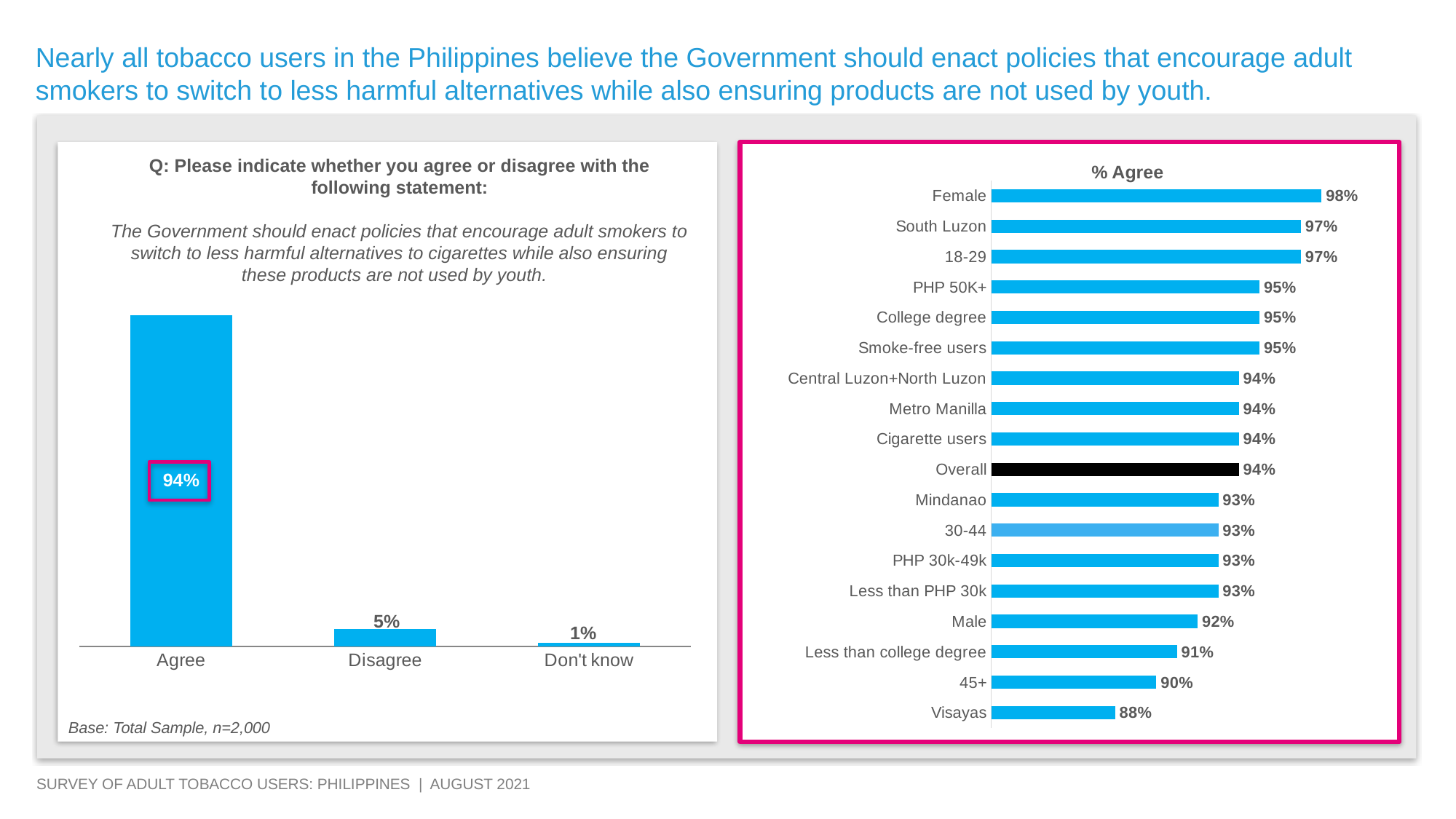
In the % Agree chart, what is the value for Overall? 94% In the left chart, what percentage of respondents answered Don't know? 1% In the % Agree chart, what is the value for Visayas? 88% In the left chart, what is the difference between the Agree and Disagree percentages? 89 percentage points In the % Agree chart, what is the difference between Female and Male? 6 percentage points In the left chart, how many response categories are shown on the x axis? 3 In the % Agree chart, which is larger, the value for 18-29 or the value for 45+? 18-29 In the % Agree chart, which category has the lowest value? Visayas In the % Agree chart, which category has the highest value? Female In the % Agree chart, how many categories are listed? 18 What kind of chart is the left chart? Bar chart In the left chart, what percentage of respondents Agree with the statement? 94%